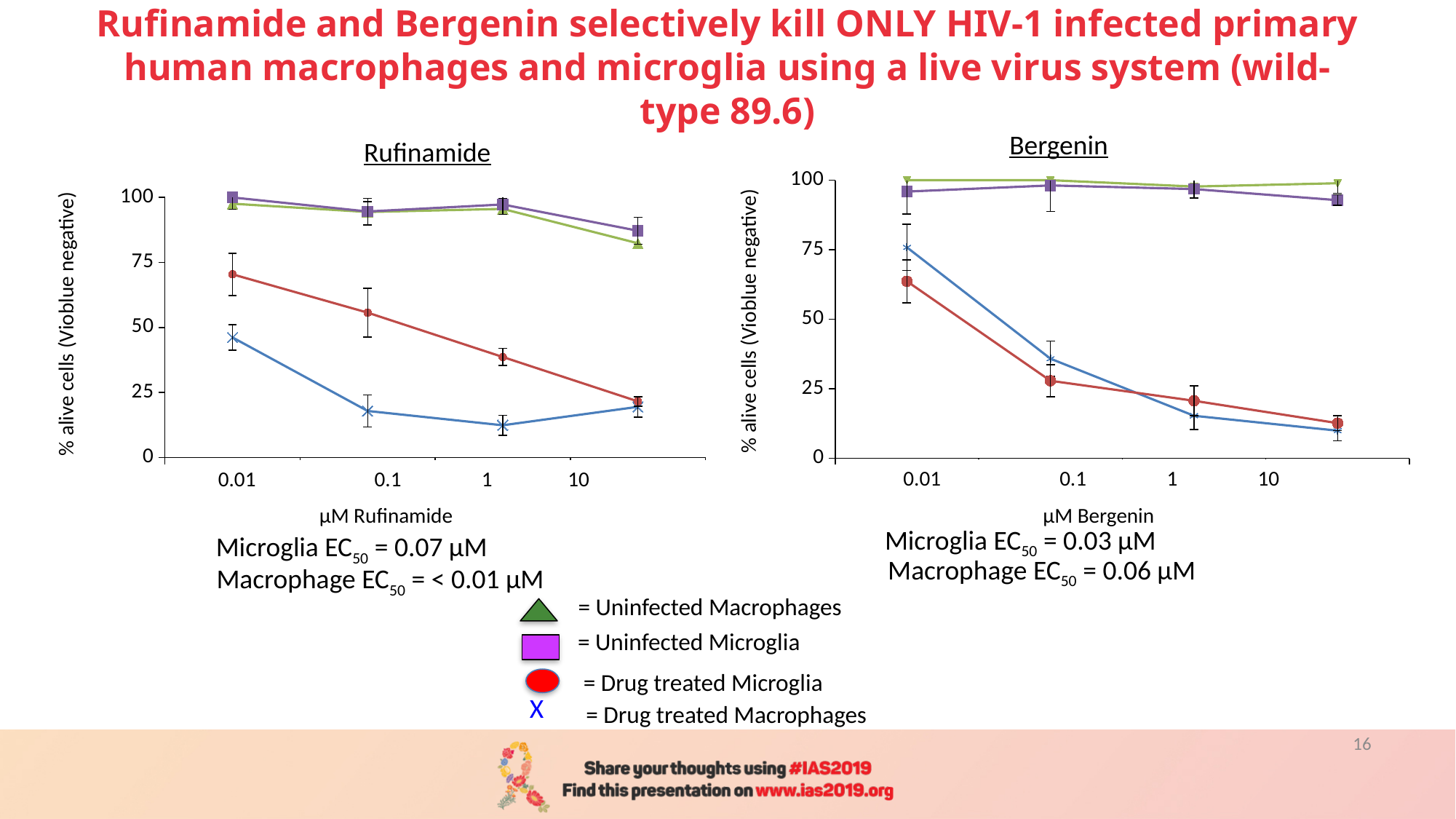
In the Rufinamide chart, which is larger at 0.1 µM: the value for Drug treated Microglia or the value for Drug treated Macrophages? Drug treated Microglia What is the x-axis label of the Rufinamide chart? µM Rufinamide In the Rufinamide chart, how many data points does the Drug treated Microglia series have? 4 In the Bergenin chart, is the value for Drug treated Microglia at 0.01 µM greater or less than 50? greater What is the y-axis label of the Bergenin chart? % alive cells (Vioblue negative) In the Bergenin chart, does the Drug treated Macrophages series rise or fall as the concentration increases along the x axis? fall In the Rufinamide chart, is the value for Drug treated Macrophages at 1 µM greater or less than 25? less In the Bergenin chart, is the value for Uninfected Microglia at 0.1 µM greater or less than 75? greater What kind of chart is the Rufinamide chart? line chart In the Bergenin chart, which is larger at 0.01 µM: the value for Drug treated Macrophages or the value for Drug treated Microglia? Drug treated Macrophages How many series does the shared legend below the charts list? 4